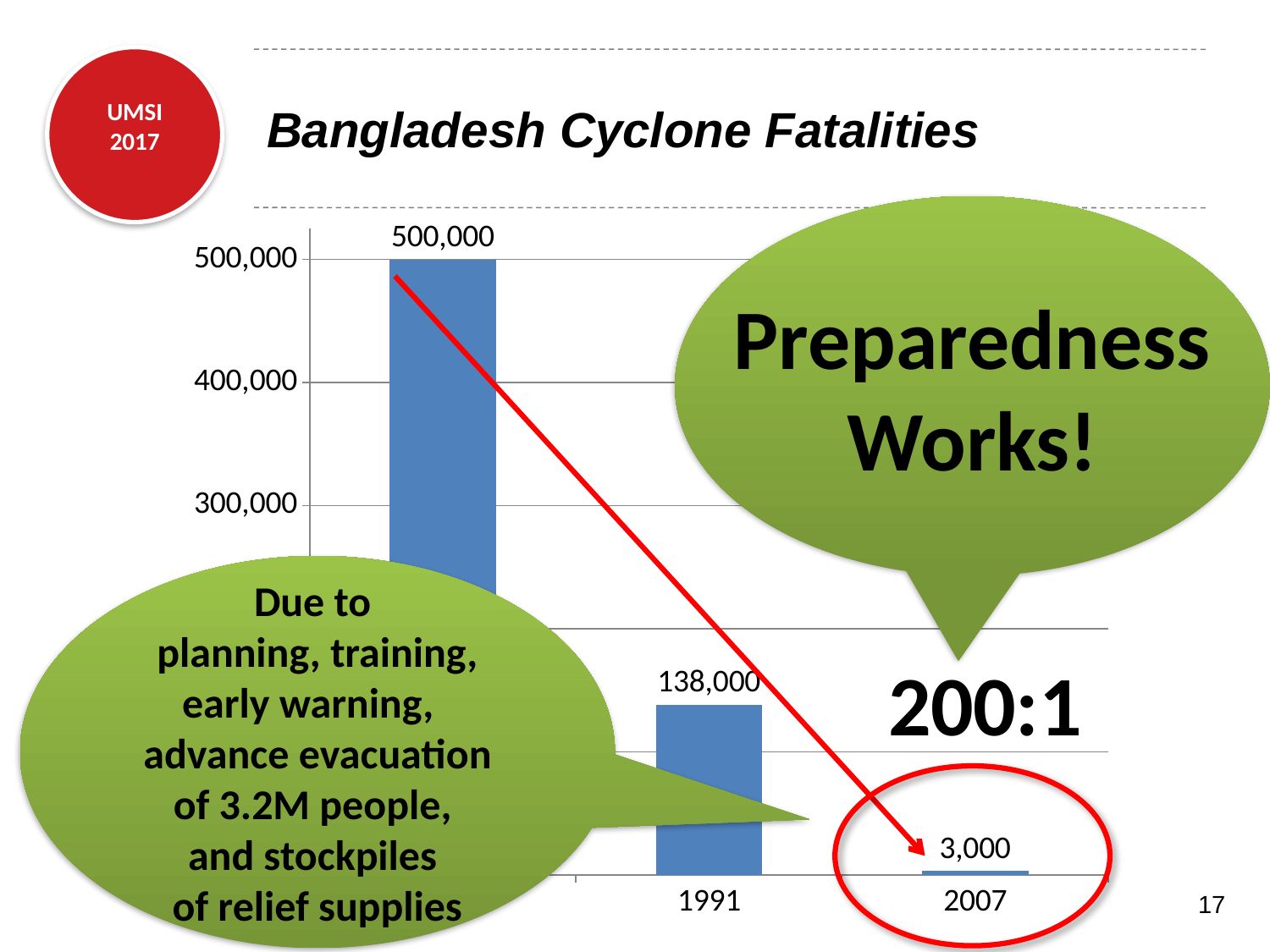
Do the fatality values rise or fall from left to right across the chart? fall Which year had more fatalities, 1991 or 2007? 1991 What is the title of the chart? Bangladesh Cyclone Fatalities Is the value for 1991 greater or less than 100,000? greater What is the number of fatalities shown for 2007? 3,000 What is the value of the tallest bar in the chart? 500,000 What is the difference in fatalities between 1991 and 2007? 135,000 How many bars are plotted in the chart? 3 What kind of chart is shown on the slide? bar chart What is the number of fatalities shown for 1991? 138,000 What is the difference between the tallest bar's value and the value for 2007? 497,000 Which year has the lowest number of fatalities? 2007